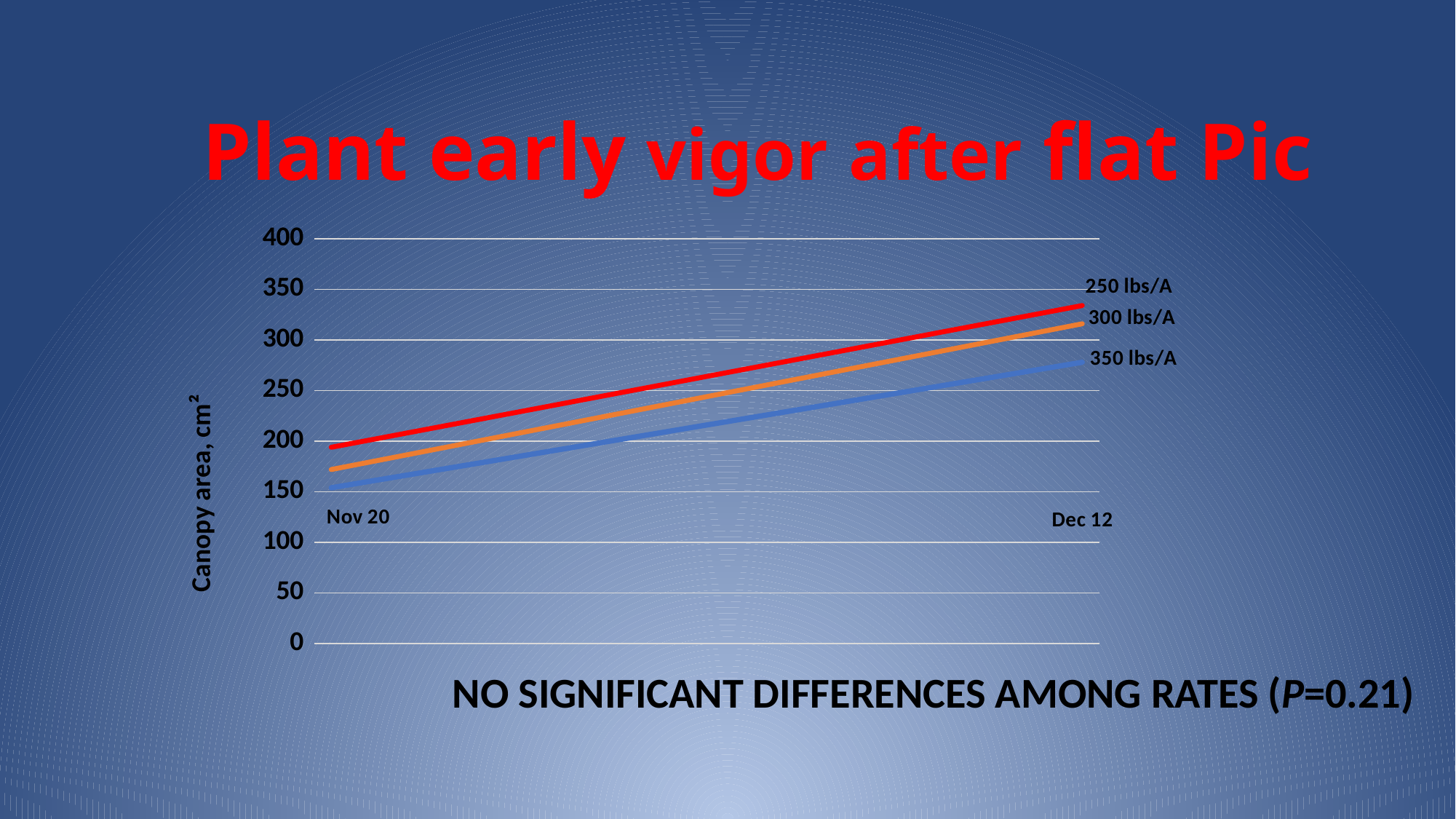
Is the canopy area for 250 lbs/A on Dec 12 greater or less than 300? greater How many dates are shown along the x axis of the chart? 2 On Nov 20, which has the larger canopy area, 250 lbs/A or 350 lbs/A? 250 lbs/A Which rate has the lowest canopy area on Dec 12? 350 lbs/A How many series (application rates) are plotted on the chart? 3 Is the canopy area for 350 lbs/A on Dec 12 greater or less than 300? less Does canopy area rise or fall from Nov 20 to Dec 12 for the 250 lbs/A rate? rise What is the label of the y axis of the chart? Canopy area, cm² What kind of chart is shown on the slide? line chart Which rate has the highest canopy area on Dec 12? 250 lbs/A What is the title of the chart on the slide? Plant early vigor after flat Pic Is the canopy area for 300 lbs/A on Nov 20 greater or less than 200? less